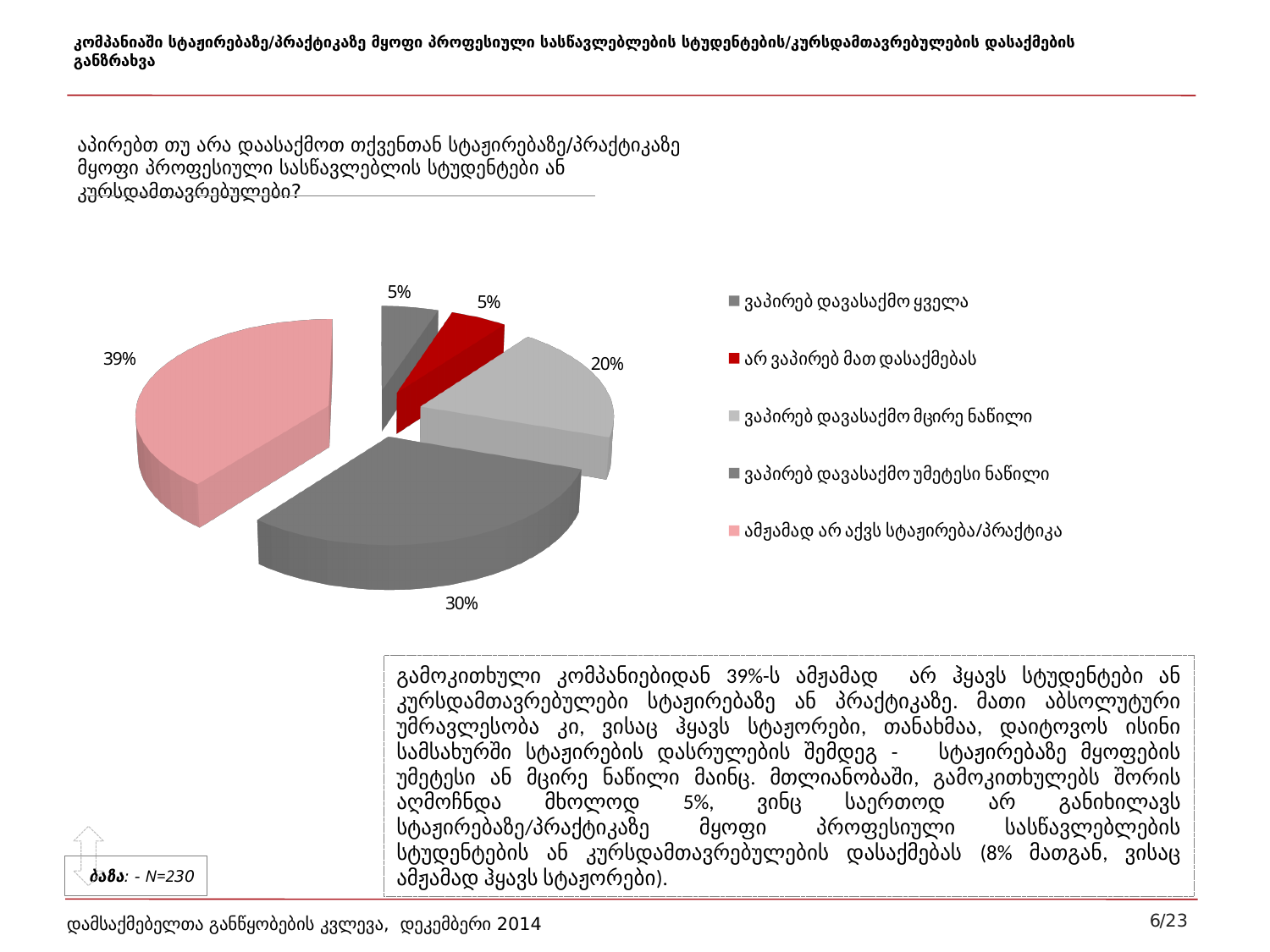
What percentage is shown for the slice "ამჟამად არ აქვს სტაჟირება/პრაქტიკა"? 39% What colour is the slice for "ამჟამად არ აქვს სტაჟირება/პრაქტიკა" in the pie chart? pink Which slice of the pie chart is the largest? ამჟამად არ აქვს სტაჟირება/პრაქტიკა What is the difference in percentage points between the "ამჟამად არ აქვს სტაჟირება/პრაქტიკა" slice and the "ვაპირებ დავასაქმო უმეტესი ნაწილი" slice? 9 What percentage is shown for the slice "არ ვაპირებ მათ დასაქმებას"? 5% How many slices does the pie chart have? 5 What kind of chart is shown on the slide? pie chart What percentage is shown for the slice "ვაპირებ დავასაქმო მცირე ნაწილი"? 20% What colour is the slice for "არ ვაპირებ მათ დასაქმებას" in the pie chart? red Which is larger: the "ვაპირებ დავასაქმო მცირე ნაწილი" slice or the "ვაპირებ დავასაქმო უმეტესი ნაწილი" slice? ვაპირებ დავასაქმო უმეტესი ნაწილი How many entries does the legend of the pie chart list? 5 What percentage is shown for the slice "ვაპირებ დავასაქმო უმეტესი ნაწილი"? 30%